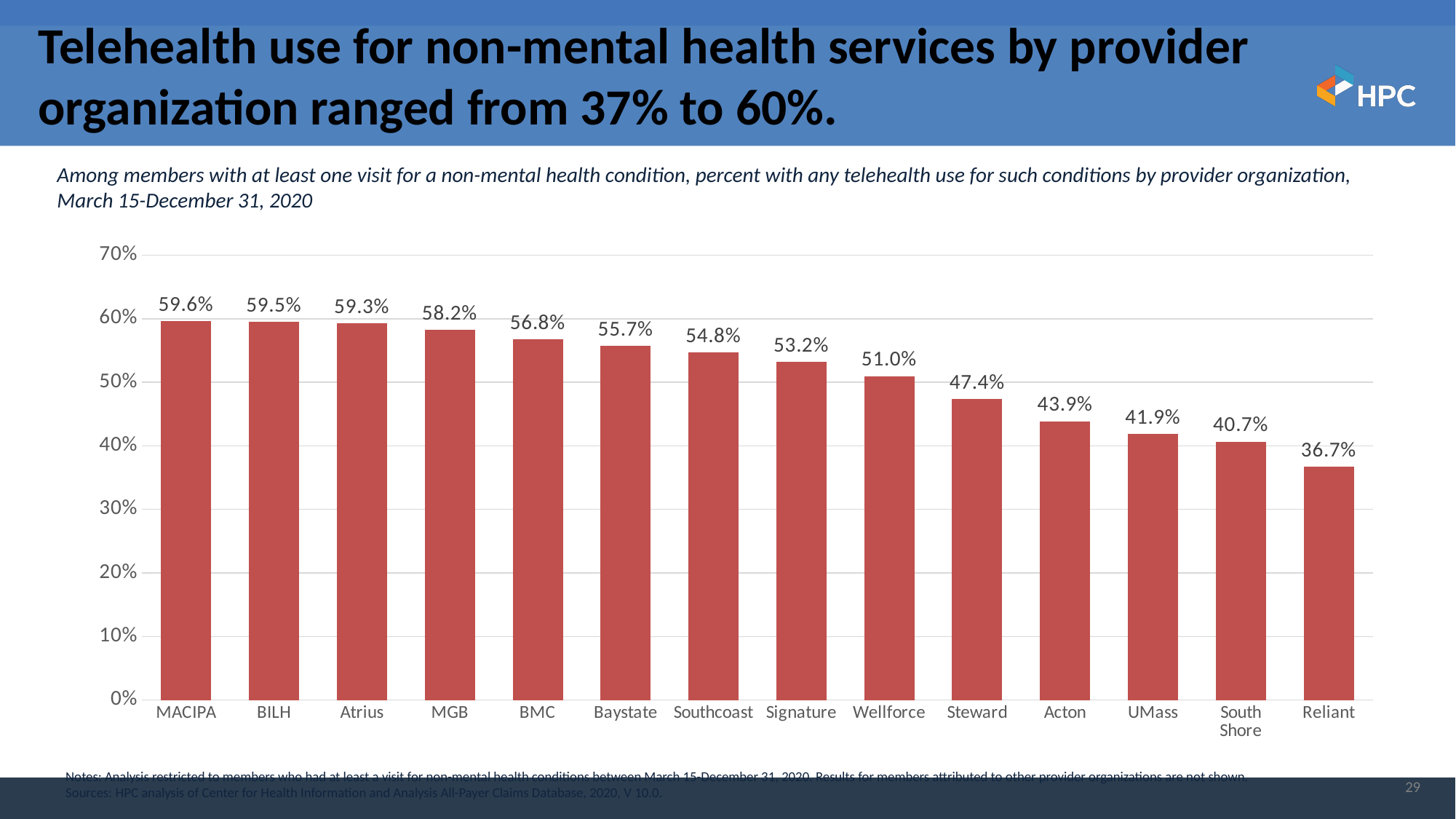
Do the values rise or fall from left to right across the chart? fall Which provider organization has the lowest value? Reliant Which has a larger value, Baystate or Signature? Baystate What kind of chart is shown on the slide? bar chart What is the value for South Shore? 40.7% What is the difference between the values for MACIPA and Reliant? 22.9 percentage points What is the difference between the values for Wellforce and Steward? 3.6 percentage points What is the value for MGB? 58.2% Which provider organization has the highest value? MACIPA What is the value for Steward? 47.4% Is the value for Acton greater or less than 50%? less How many provider organizations are shown in the chart? 14